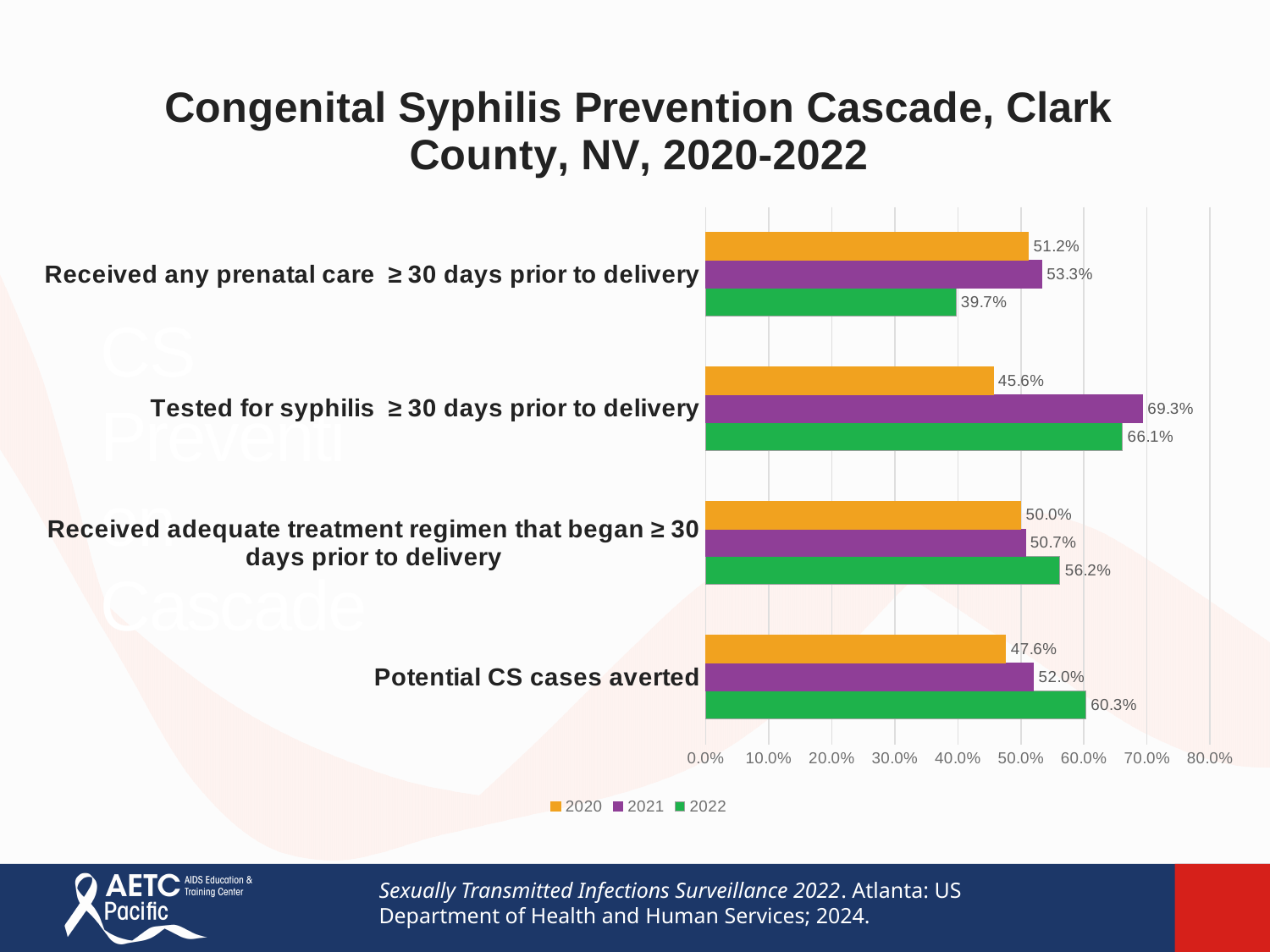
How many series does the legend list? 3 Which category has the highest 2021 value? Tested for syphilis ≥ 30 days prior to delivery How many categories are shown on the chart? 4 Which colour represents 2021 in the legend? Purple What is the 2020 value for "Potential CS cases averted"? 47.6% Which category has the lowest 2022 value? Received any prenatal care ≥ 30 days prior to delivery What is the 2022 value for "Tested for syphilis ≥ 30 days prior to delivery"? 66.1% What is the 2021 value for "Received any prenatal care ≥ 30 days prior to delivery"? 53.3% What kind of chart is shown on the slide? Bar chart Is the 2022 value for "Received any prenatal care ≥ 30 days prior to delivery" greater or less than 40.0%? less What is the difference between the 2021 and 2020 values for "Tested for syphilis ≥ 30 days prior to delivery"? 23.7% For "Potential CS cases averted", which year has the larger value, 2020 or 2022? 2022